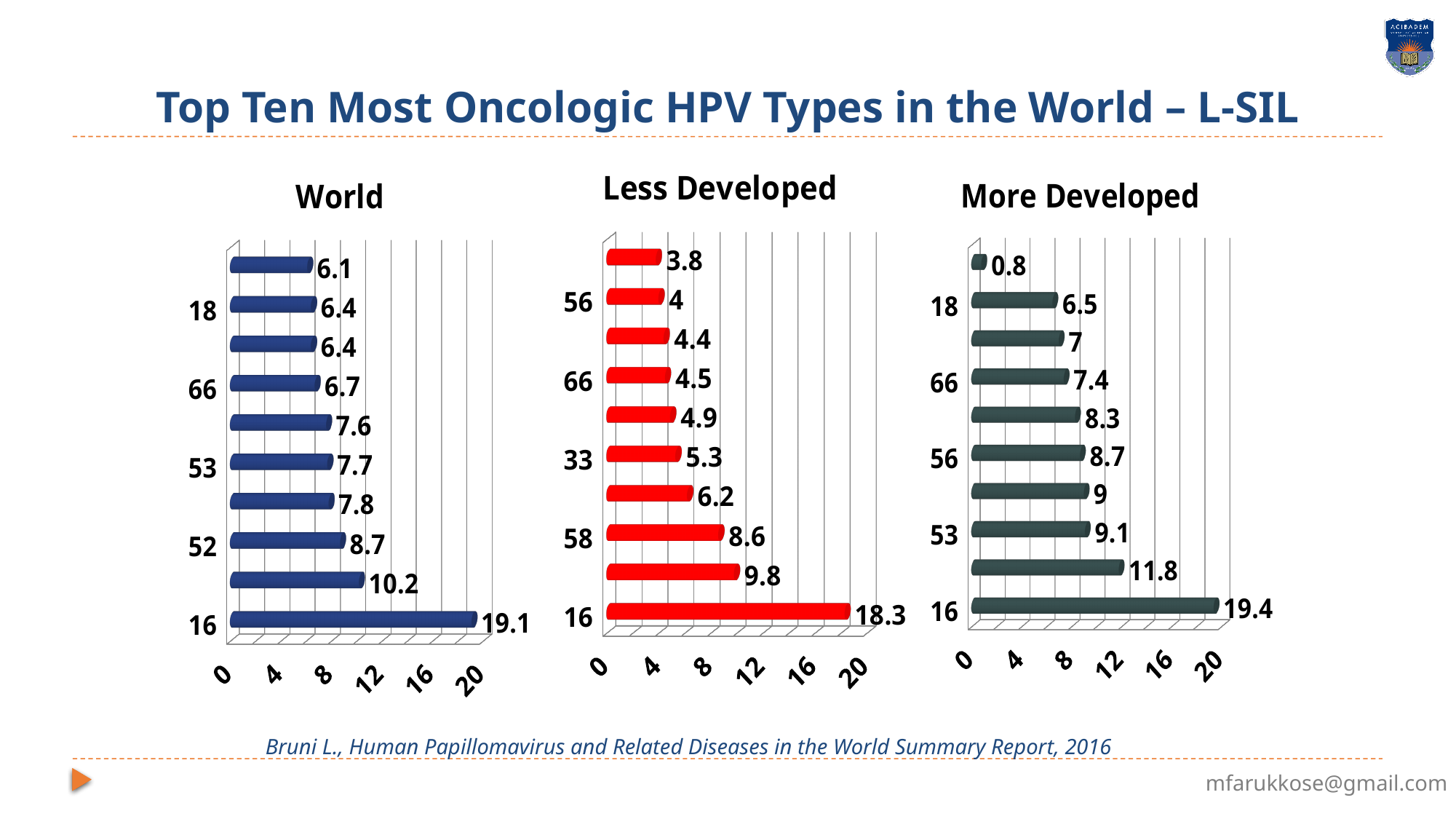
In the More Developed chart, what is the lowest value shown on any bar? 0.8 In the More Developed chart, is the value for HPV type 16 greater or less than 16? greater In the World chart, what is the difference between the values for HPV type 16 and HPV type 18? 12.7 In the Less Developed chart, which has the larger value, HPV type 58 or HPV type 33? 58 In the More Developed chart, what is the value for HPV type 18? 6.5 In the World chart, what is the lowest value shown on any bar? 6.1 In the Less Developed chart, which labelled HPV type has the highest value? 16 In the More Developed chart, what is the value for HPV type 66? 7.4 In the World chart, what is the value for HPV type 16? 19.1 What kind of chart is the World chart? bar chart How many bars are plotted in the Less Developed chart? 10 In the Less Developed chart, what is the value for HPV type 58? 8.6